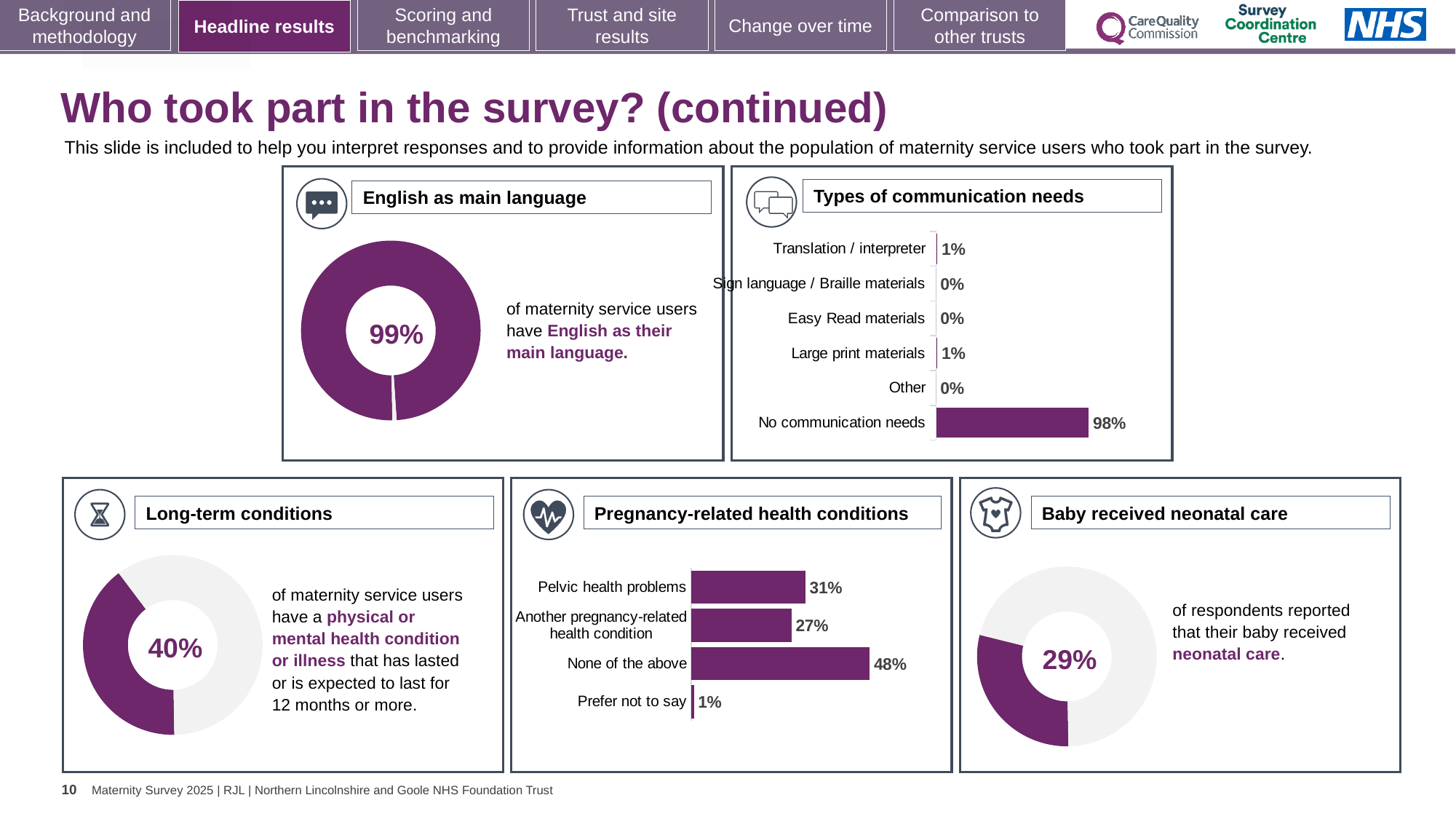
In the 'Pregnancy-related health conditions' chart, what is the difference between 'None of the above' and 'Another pregnancy-related health condition'? 21% How many categories are shown in the 'Types of communication needs' chart? 6 In the 'Long-term conditions' donut chart, what percentage of maternity service users have a physical or mental health condition or illness? 40% In the 'Pregnancy-related health conditions' chart, which category has the lowest value? Prefer not to say In the 'Types of communication needs' chart, what is the value for 'No communication needs'? 98% In the 'Pregnancy-related health conditions' chart, which is larger: 'Pelvic health problems' or 'Another pregnancy-related health condition'? Pelvic health problems In the 'Pregnancy-related health conditions' chart, what is the value for 'Pelvic health problems'? 31% In the 'Types of communication needs' chart, what is the value for 'Translation / interpreter'? 1% In the 'Types of communication needs' chart, which category has the highest value? No communication needs In the 'Pregnancy-related health conditions' chart, which category has the highest value? None of the above In the 'Baby received neonatal care' donut chart, what percentage of respondents reported their baby received neonatal care? 29% What kind of chart is used in the 'Pregnancy-related health conditions' panel? Bar chart